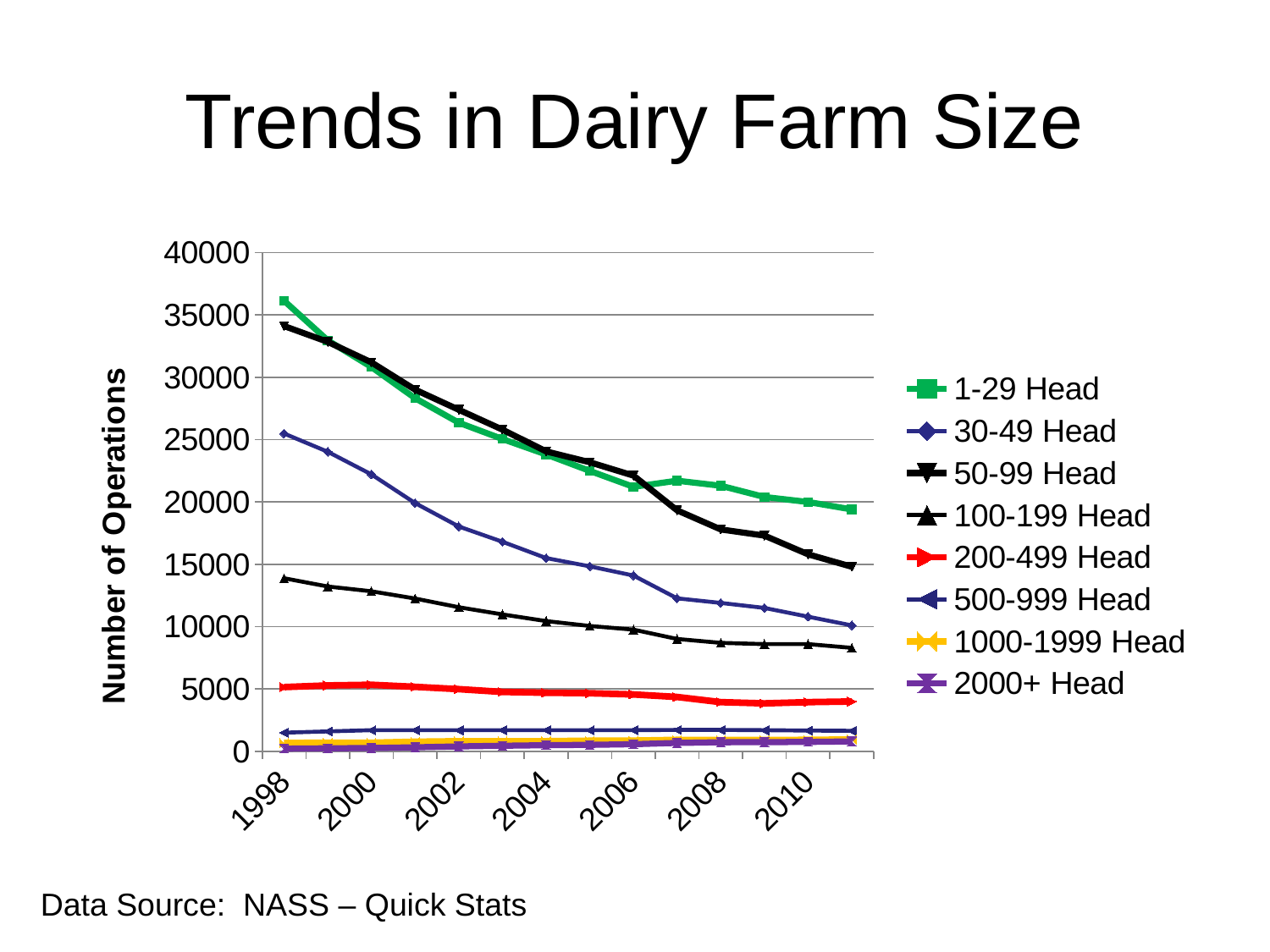
Does the number of operations for 1-29 Head rise or fall from 1998 to the end of the series? fall How many series does the legend list? 8 What kind of chart is shown on the slide? line chart Is the value for 1-29 Head in 1998 greater or less than 35000? greater What is the title of the chart? Trends in Dairy Farm Size What is the label on the vertical axis? Number of Operations Which series has the lowest number of operations in 1998? 2000+ Head In 2010, which series has more operations, 1-29 Head or 50-99 Head? 1-29 Head Is the value for 100-199 Head in 1998 greater or less than 15000? less Which series has the highest number of operations in 1998? 1-29 Head Is the value for 100-199 Head in 2008 greater or less than 10000? less Does the number of operations for 30-49 Head rise or fall over the period shown? fall